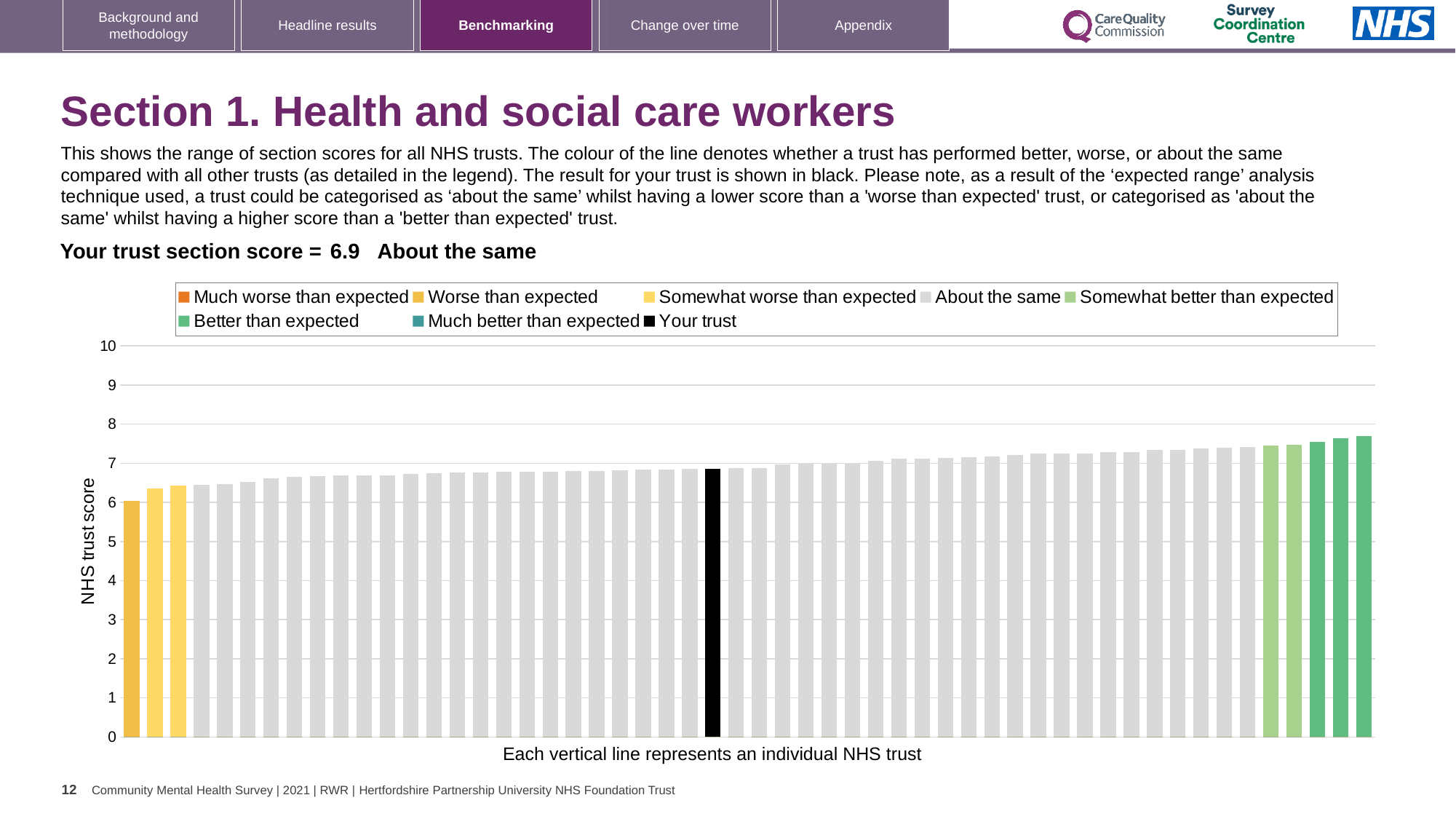
Is your trust's bar higher or lower than the leftmost bar in the chart? higher Do the bar values rise or fall from left to right across the chart? rise Is the value for your trust's bar greater or less than 5? greater Is the value of the highest bar in the chart greater or less than 8? less Is the value of the lowest bar in the chart greater or less than 7? less What is the section score for your trust shown on the slide? 6.9 Which benchmarking category is your trust placed in for this section? About the same How many entries does the chart legend list? 8 How many bars are coloured as 'Worse than expected' in the chart? 1 What is the label on the vertical axis of the chart? NHS trust score What kind of chart is shown on the slide? bar chart What colour is the bar representing your trust in the chart? black